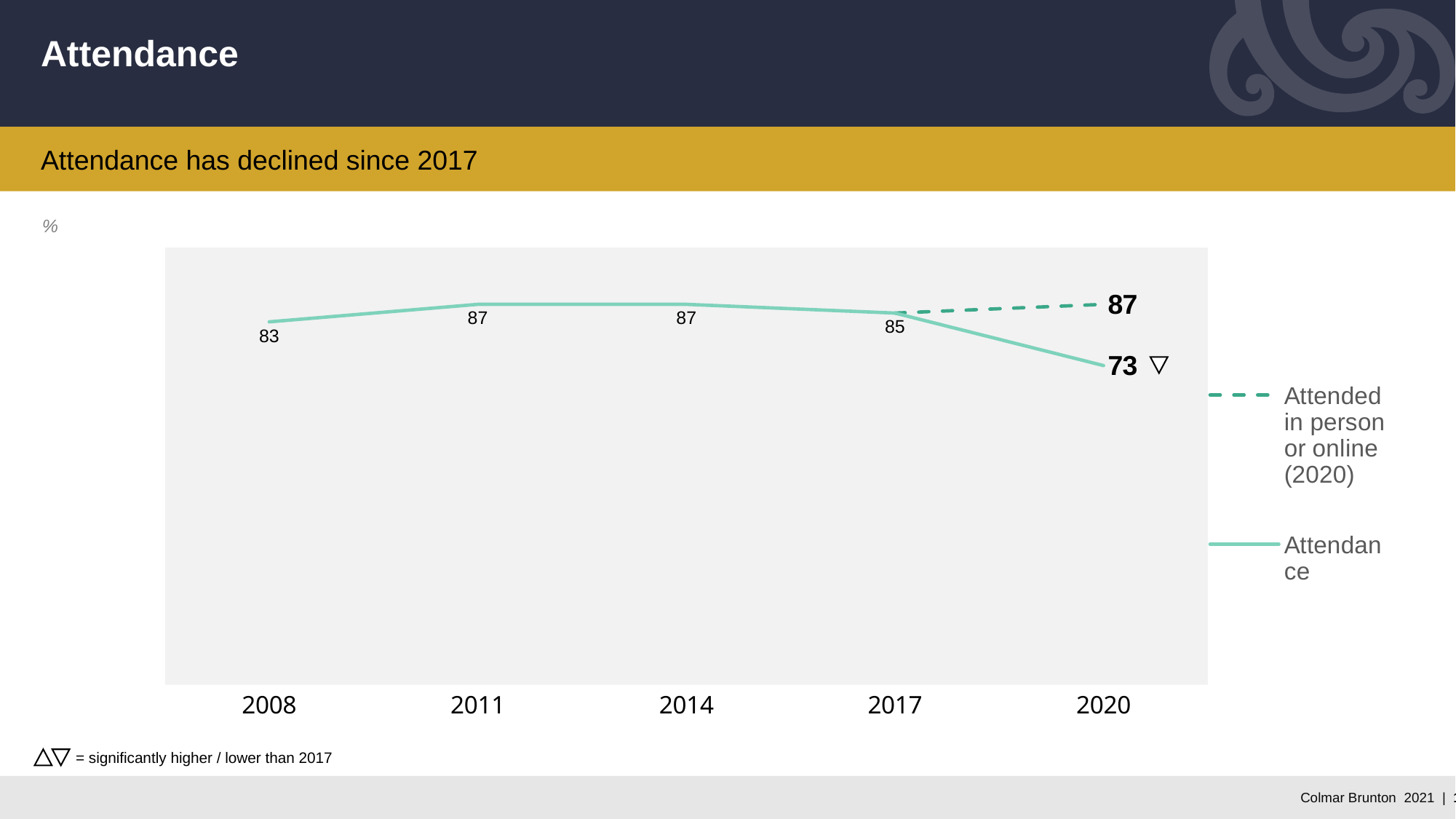
What is the difference between the Attendance value in 2008 and in 2011? 4 What kind of chart is shown on the slide? Line chart Does the Attendance series rise or fall between 2017 and 2020? Fall What is the Attendance value for 2008? 83 In which year is the Attendance series lowest? 2020 What is the Attendance value for 2020? 73 How many years are shown on the x axis? 5 What is the value for 'Attended in person or online (2020)' in 2020? 87 What is the Attendance value for 2017? 85 How many series does the legend list? 2 Which is larger in 2020: Attendance or Attended in person or online? Attended in person or online What is the difference between the Attendance value in 2017 and in 2020? 12